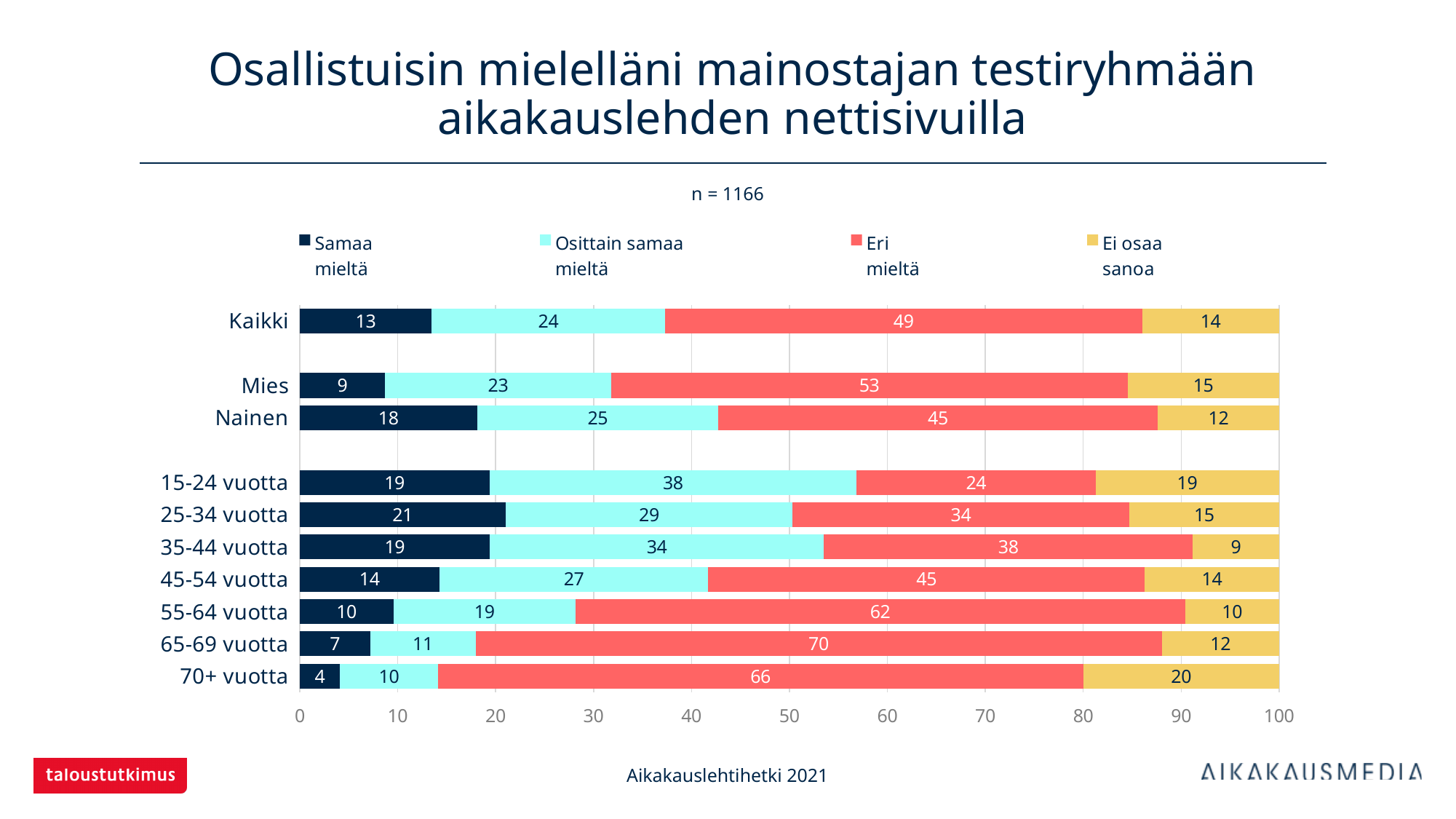
What is the value of "Samaa mieltä" for Nainen? 18 What kind of chart is shown on the slide? Stacked bar chart Which category has the lowest value for "Samaa mieltä"? 70+ vuotta What is the value of "Eri mieltä" for Kaikki? 49 What is the value of "Ei osaa sanoa" for 70+ vuotta? 20 What is the difference between the "Eri mieltä" values for Mies and Nainen? 8 What is the total of the stacked bar for 35-44 vuotta? 100 How many series does the legend list? 4 Which category has the highest value for "Eri mieltä"? 65-69 vuotta Which is larger, the "Samaa mieltä" value for 25-34 vuotta or for 45-54 vuotta? 25-34 vuotta What is the value of "Osittain samaa mieltä" for 15-24 vuotta? 38 How many categories are shown on the y axis? 10